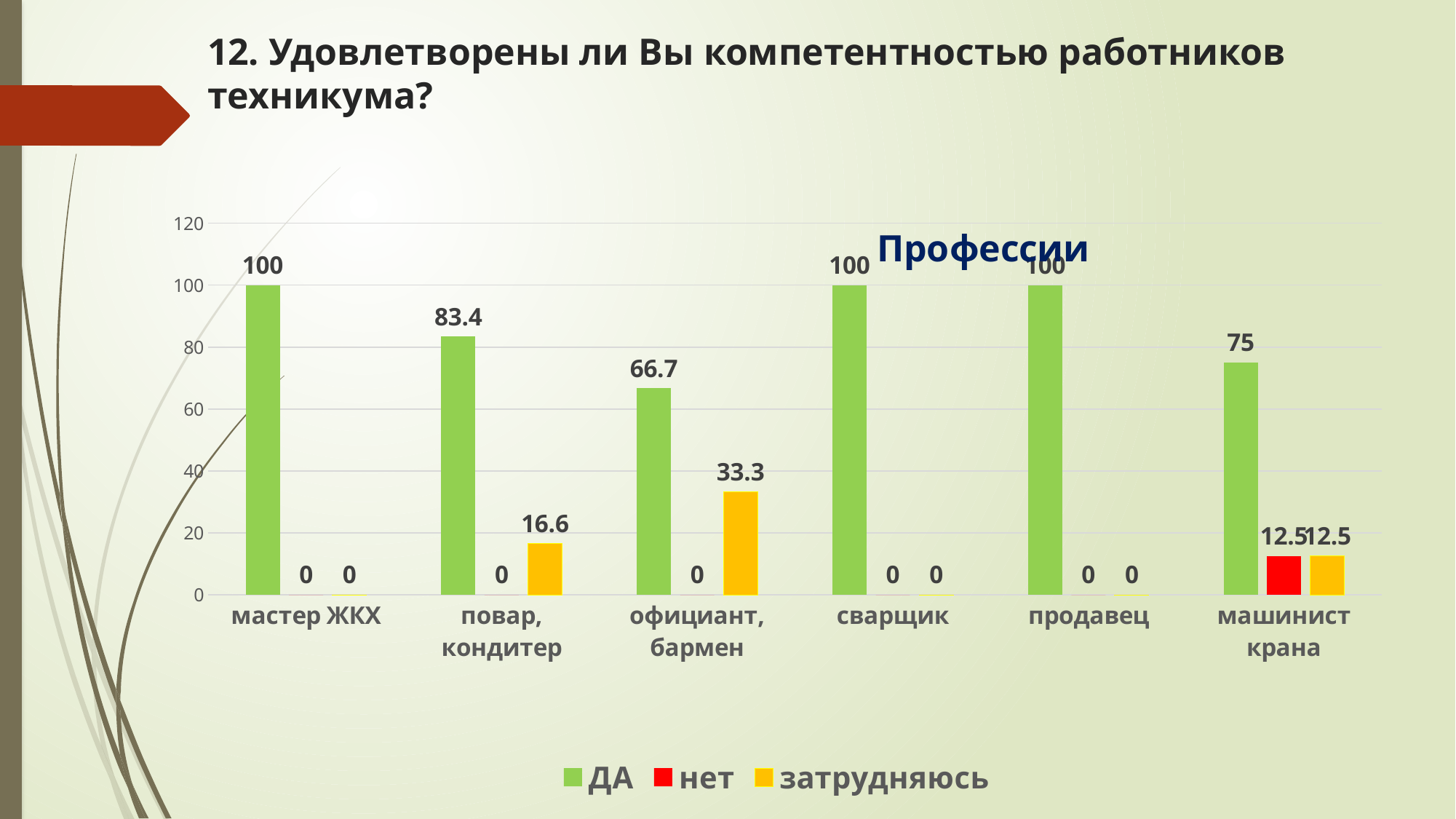
What is the value of the ДА series for повар, кондитер? 83.4 Which category has the lowest value in the ДА series? официант, бармен How many categories are shown on the x axis? 6 What is the value of the ДА series for машинист крана? 75 Which is larger: the затрудняюсь value for повар, кондитер or for машинист крана? повар, кондитер What kind of chart is shown on the slide? bar chart How many series does the legend list? 3 What is the value of the нет series for машинист крана? 12.5 What is the value of the затрудняюсь series for официант, бармен? 33.3 Which category has the highest value in the затрудняюсь series? официант, бармен What is the title shown on the chart? Профессии What is the difference between the ДА values for повар, кондитер and официант, бармен? 16.7